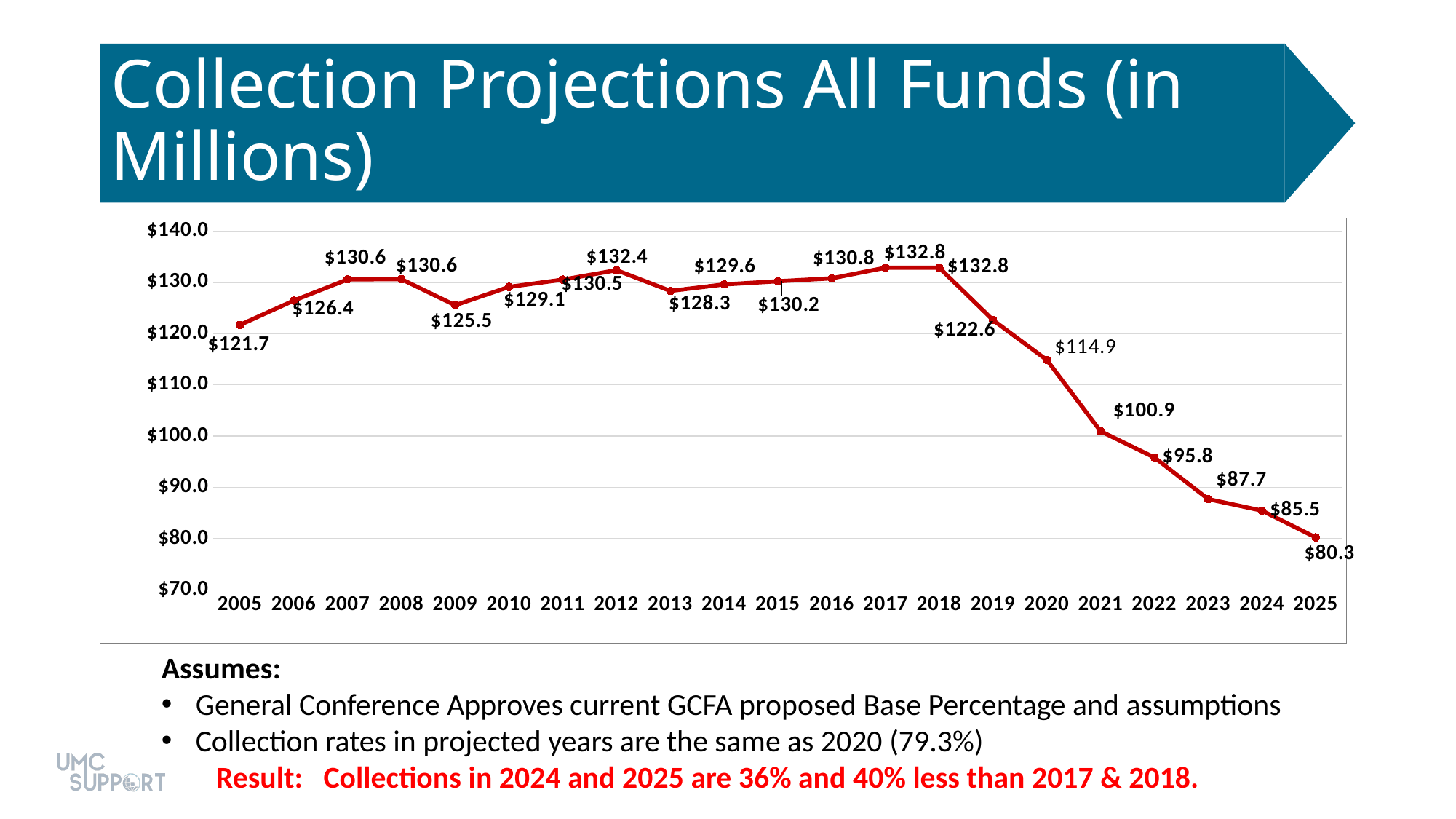
What is the difference between the values for 2006 and 2005? $4.7 What is the value for 2020? $114.9 Is the value for 2021 greater or less than $110.0? less Do the values rise or fall from 2018 to 2025? fall What is the value for 2025? $80.3 How many years are plotted on the x axis? 21 Which year has the larger value, 2012 or 2016? 2012 What is the difference between the values for 2018 and 2025? $52.5 What is the highest value plotted on the chart? $132.8 Which year has the lowest value? 2025 What is the value for 2009? $125.5 What kind of chart is shown on the slide? line chart